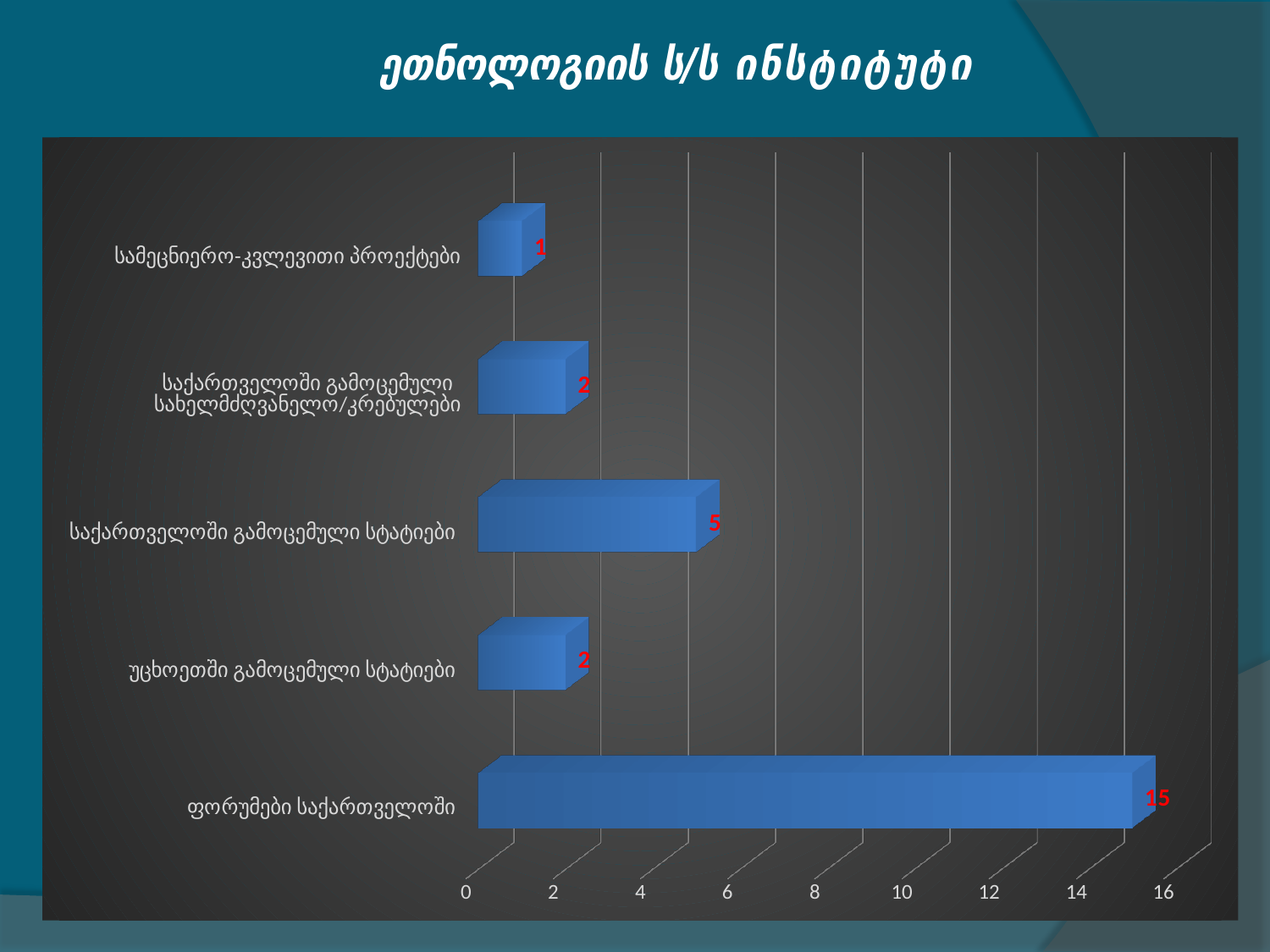
Is the value for ფორუმები საქართველოში greater or less than 10? greater What is the title of the slide? ეთნოლოგიის ს/ს ინსტიტუტი What is the value for ფორუმები საქართველოში? 15 Which category has the lowest value? სამეცნიერო-კვლევითი პროექტები What is the difference between the values for ფორუმები საქართველოში and საქართველოში გამოცემული სტატიები? 10 What kind of chart is shown on the slide? bar chart What is the value for უცხოეთში გამოცემული სტატიები? 2 How many categories are shown in the chart? 5 Which is larger: the value for საქართველოში გამოცემული სტატიები or the value for უცხოეთში გამოცემული სტატიები? საქართველოში გამოცემული სტატიები Which category has the highest value? ფორუმები საქართველოში What is the value for საქართველოში გამოცემული სტატიები? 5 What is the value for სამეცნიერო-კვლევითი პროექტები? 1